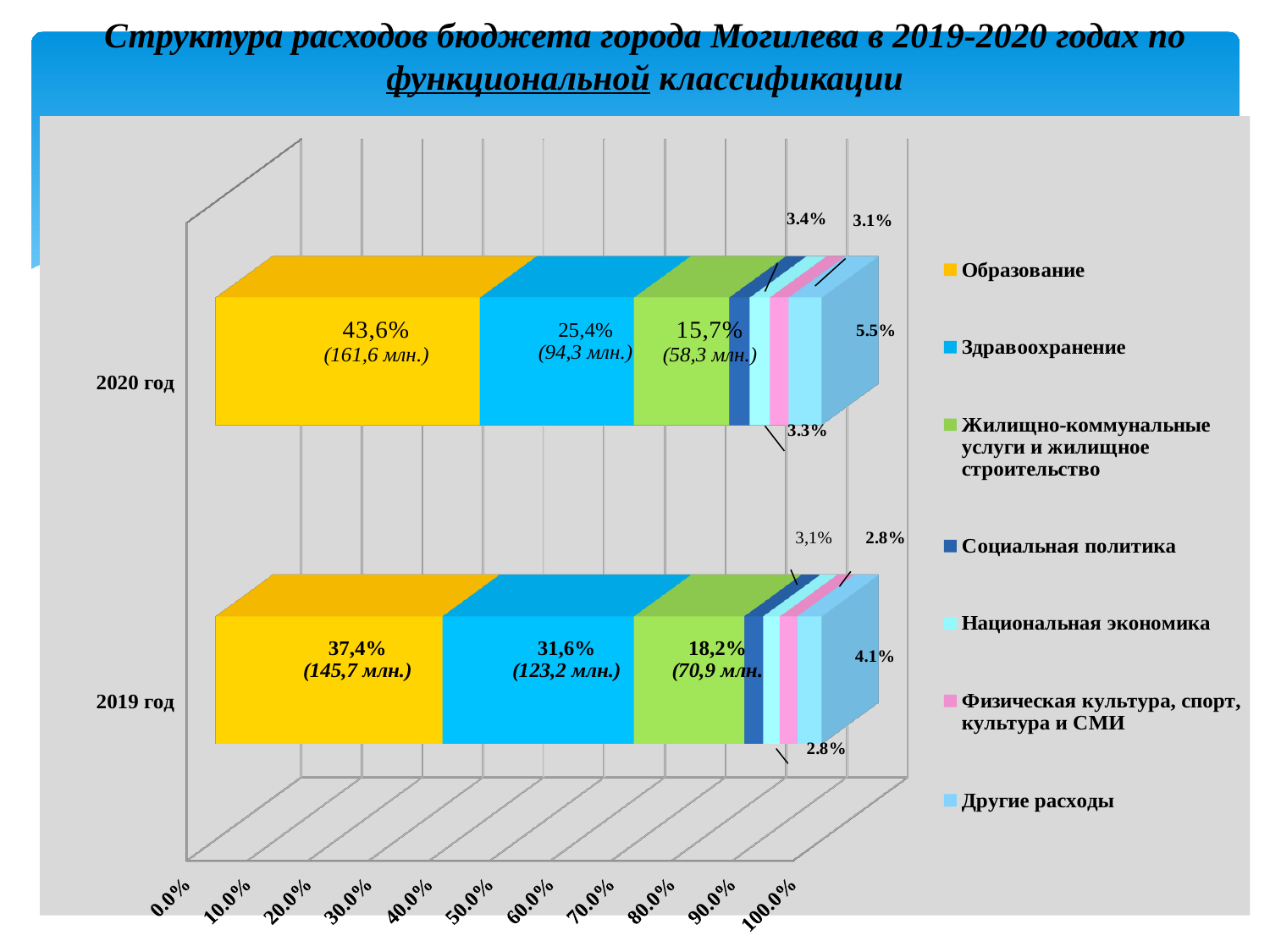
What kind of chart is shown on the slide? Stacked bar chart What share of the 2020 budget expenditure went to Образование? 43,6% How many years (bars) are shown in the chart? 2 What amount in millions is shown for Образование in 2019? 145,7 млн. What is the difference in millions between Здравоохранение in 2019 and in 2020? 28,9 млн. By how many percentage points did the share of Образование change from 2019 to 2020? 6,2 Which expenditure category has the largest share in 2020? Образование How many series does the legend list? 7 What share of the 2019 budget expenditure went to Здравоохранение? 31,6% What amount in millions is shown for Жилищно-коммунальные услуги и жилищное строительство in 2020? 58,3 млн. Which category is listed first in the legend? Образование Which year has the larger share for Образование, 2019 or 2020? 2020